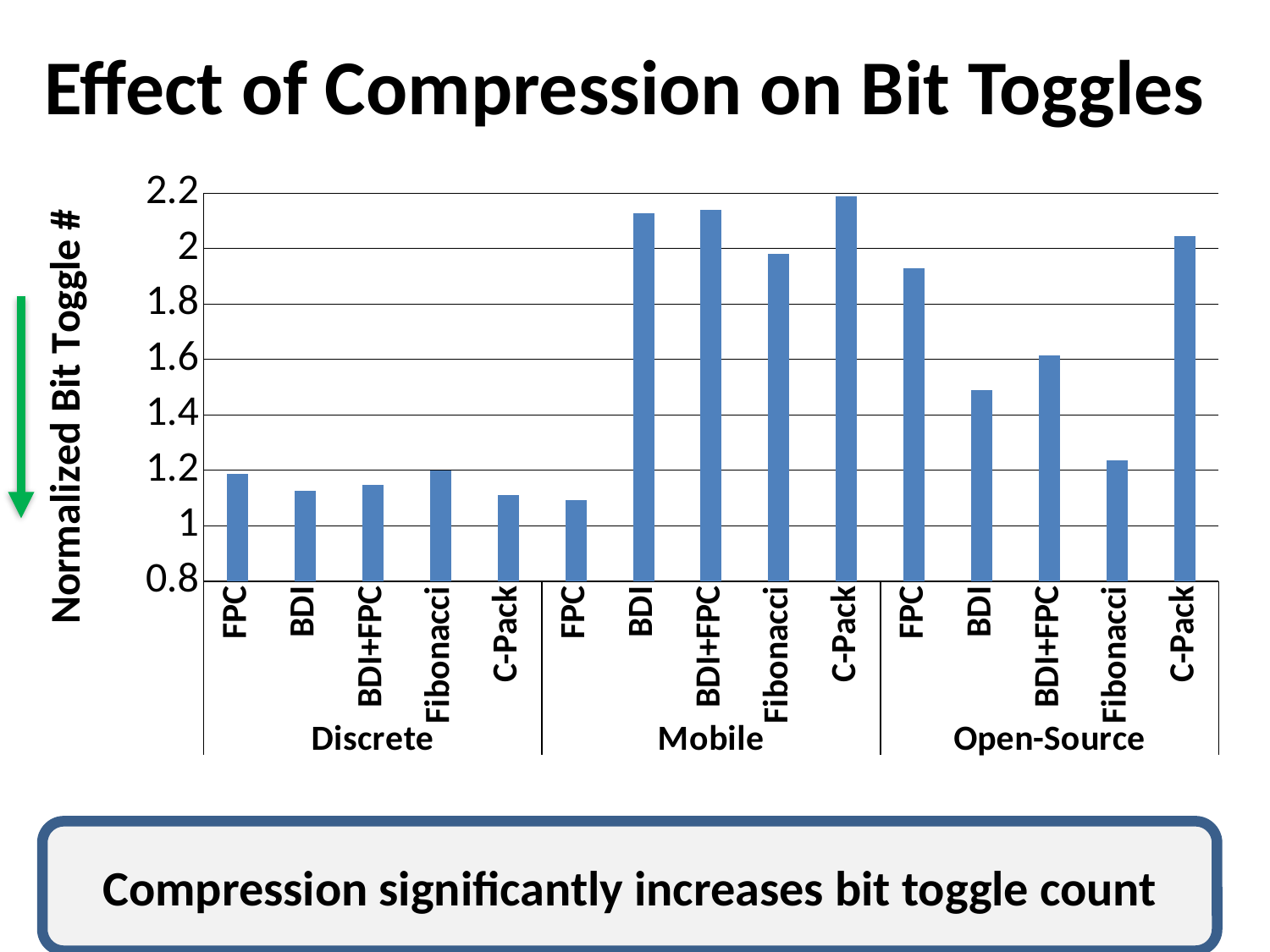
What kind of chart is shown on the slide? bar chart How many application groups are labeled along the x axis? 3 Within the Open-Source group, which compression algorithm has the lowest normalized bit toggle count? Fibonacci Within the Open-Source group, which compression algorithm has the highest normalized bit toggle count? C-Pack How many bars are plotted in the chart? 15 Is the value for FPC in the Open-Source group greater or less than 1.8? greater Is the value for Fibonacci in the Discrete group greater or less than 1.4? less What is the y-axis title of the chart? Normalized Bit Toggle # Which is larger: the value for FPC in the Open-Source group or the value for BDI in the Open-Source group? FPC in the Open-Source group Is the value for BDI in the Mobile group greater or less than 2? greater Which group has the tallest bar in the chart? Mobile Which is larger: the value for BDI in the Mobile group or the value for BDI in the Discrete group? BDI in the Mobile group